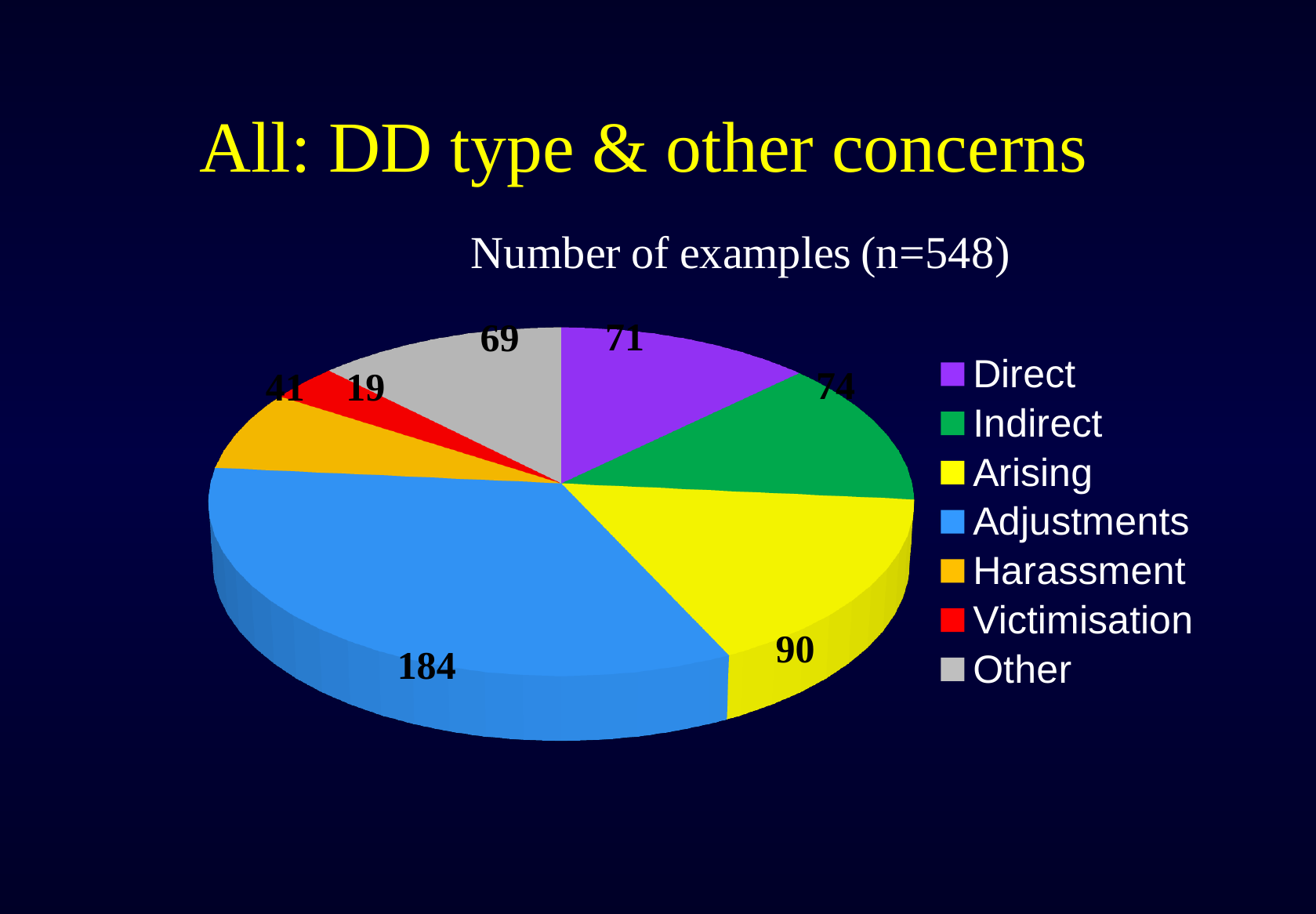
What is the number of examples for Arising? 90 What is the difference between the number of examples for Adjustments and Arising? 94 Which category has the largest number of examples? Adjustments Which category has the smallest number of examples? Victimisation What colour is the Adjustments slice? Blue What is the difference between the number of examples for Harassment and Victimisation? 22 Which has more examples, Direct or Harassment? Direct What is the number of examples for Victimisation? 19 What is the number of examples for Other? 69 How many categories does the pie chart show? 7 What is the number of examples for Adjustments? 184 What kind of chart is shown on the slide? Pie chart